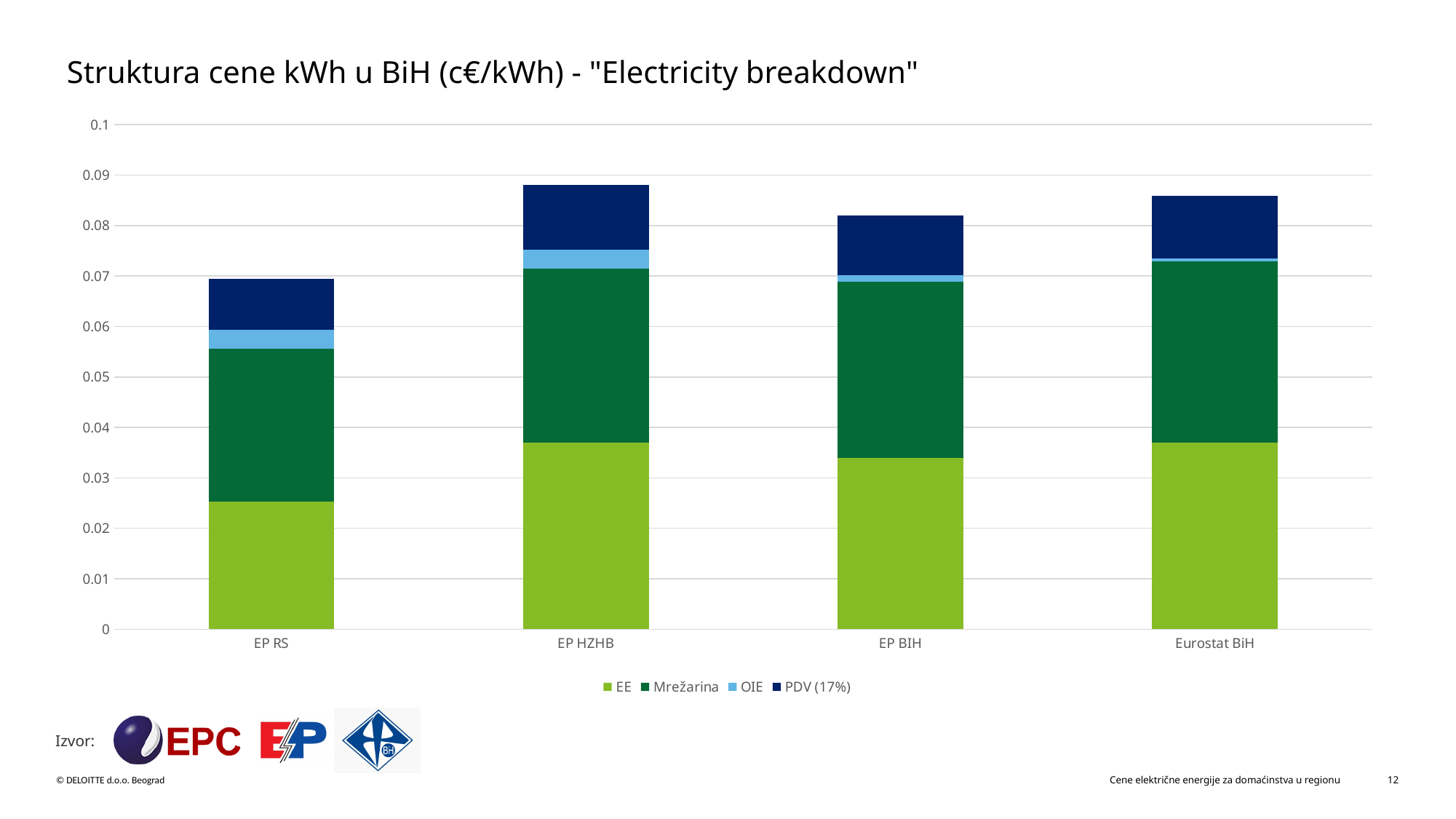
How many series does the chart legend list? 4 Which category has the lowest total bar height? EP RS How many categories are shown on the x axis of the chart? 4 Is the total bar height for EP HZHB greater or less than 0.08? greater Is the EE segment for EP RS greater or less than 0.03? less Is the total bar height for EP RS greater or less than 0.06? greater Which series is shown at the bottom of each stacked bar? EE What is the title of the chart? Struktura cene kWh u BiH (c€/kWh) - "Electricity breakdown" Which is larger, the EE segment for EP HZHB or the EE segment for EP RS? EP HZHB What kind of chart is shown on the slide? Stacked bar chart